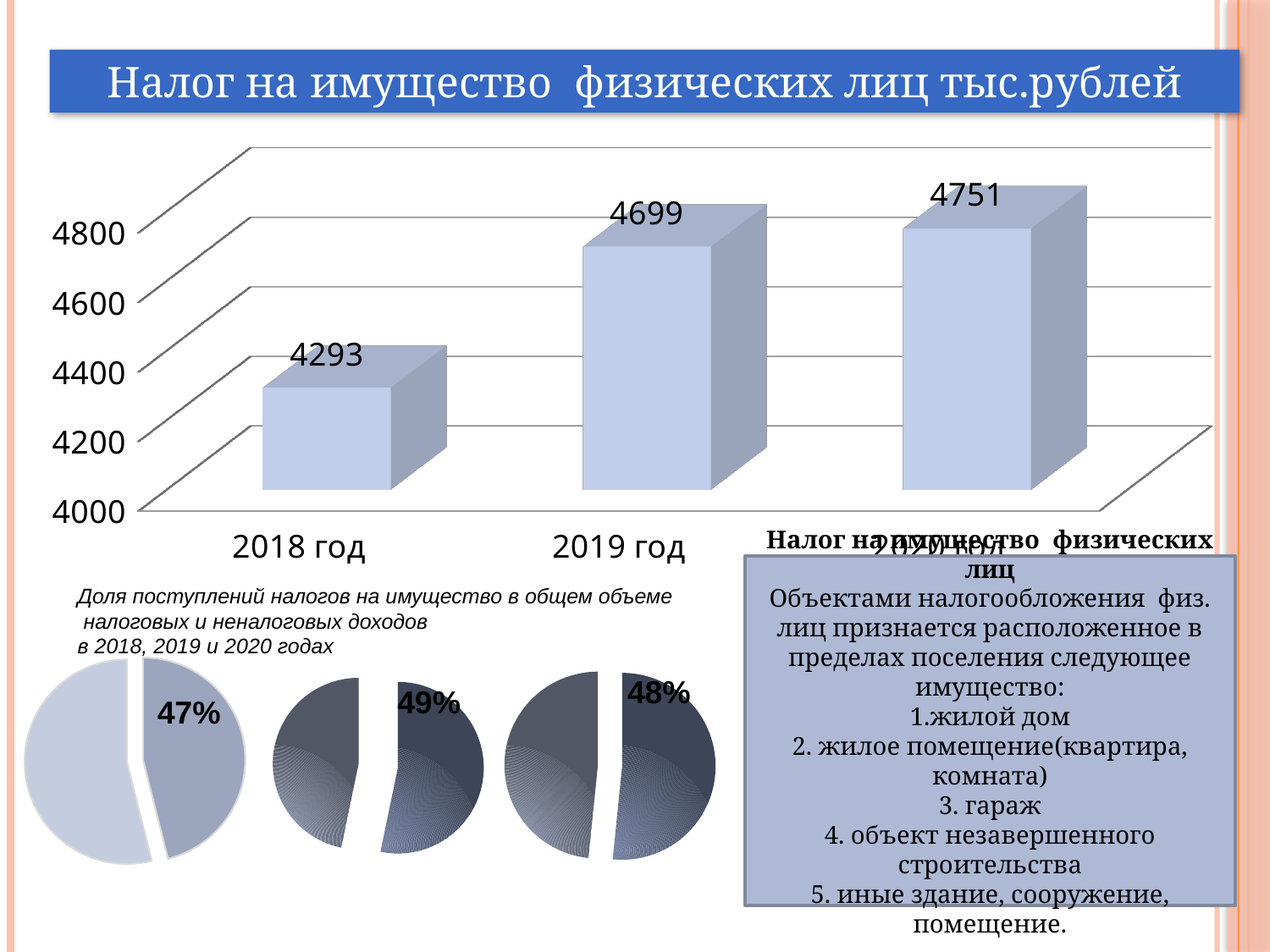
What share is labelled on the leftmost pie chart at the bottom of the slide? 47% On the bar chart, what is the value for 2019 год? 4699 What kind of chart is the chart at the top of the slide? bar chart On the bar chart, what is the value for 2018 год? 4293 On the bar chart, which is larger: the value for 2018 год or the value for 2019 год? 2019 год On the bar chart, what is the value shown on the rightmost bar? 4751 How many bars are shown on the bar chart? 3 On the bar chart, do the values rise or fall from left to right? rise On the bar chart, which category has the lowest value? 2018 год On the bar chart, is the value for 2018 год greater or less than 4400? less On the bar chart, what is the difference between the values for 2019 год and 2018 год? 406 What is the title of the bar chart at the top of the slide? Налог на имущество физических лиц тыс.рублей